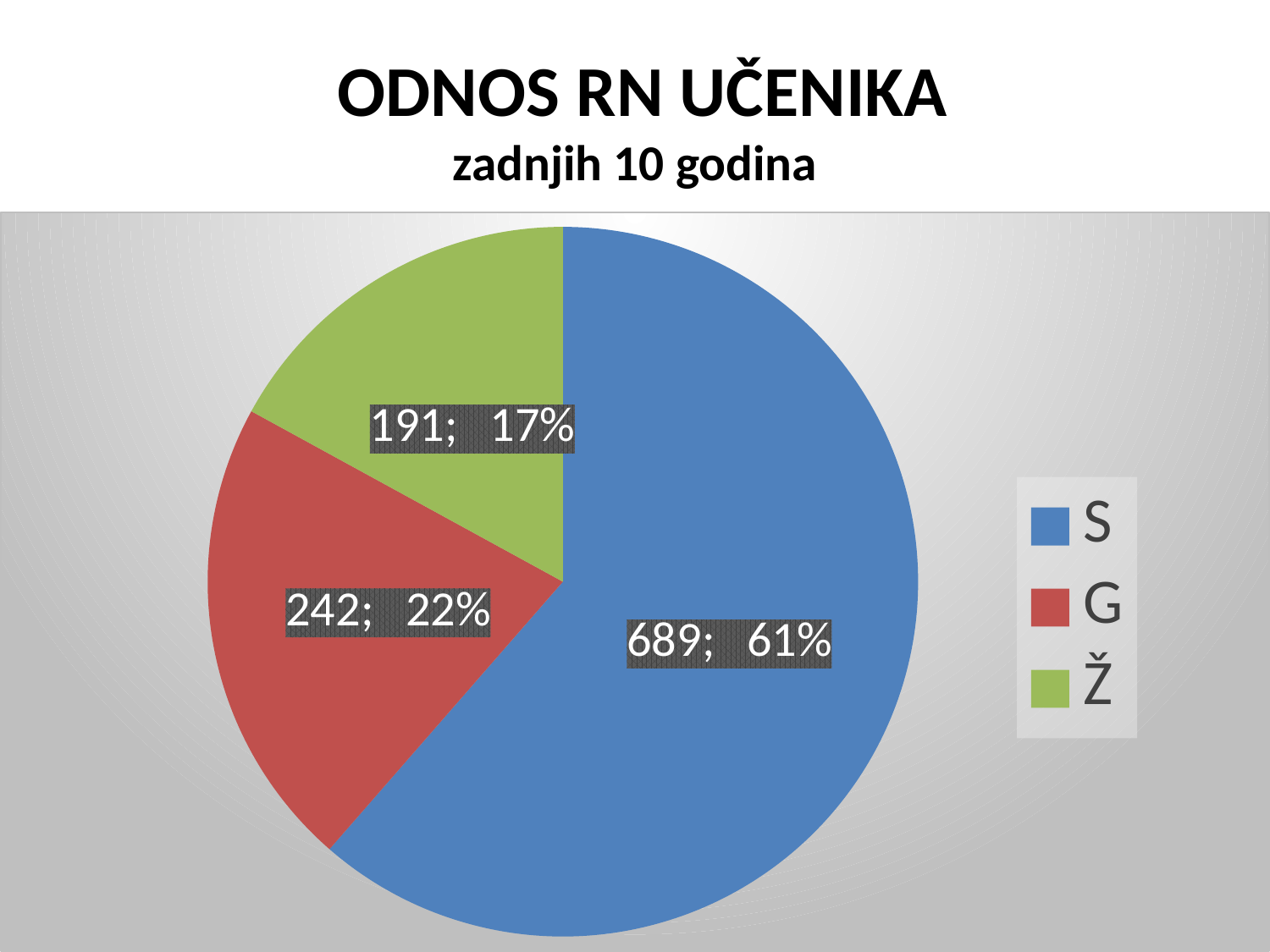
What is the difference between the values for S and G? 447 What share of the pie does Ž represent? 17% What kind of chart is shown on the slide? pie chart Which category has the smallest slice? Ž What is the value for G? 242 How many categories does the legend list? 3 What share of the pie does S represent? 61% Which is larger, the value for G or the value for Ž? G What is the value for S? 689 What share of the pie does G represent? 22% What is the value for Ž? 191 Which category has the largest slice? S